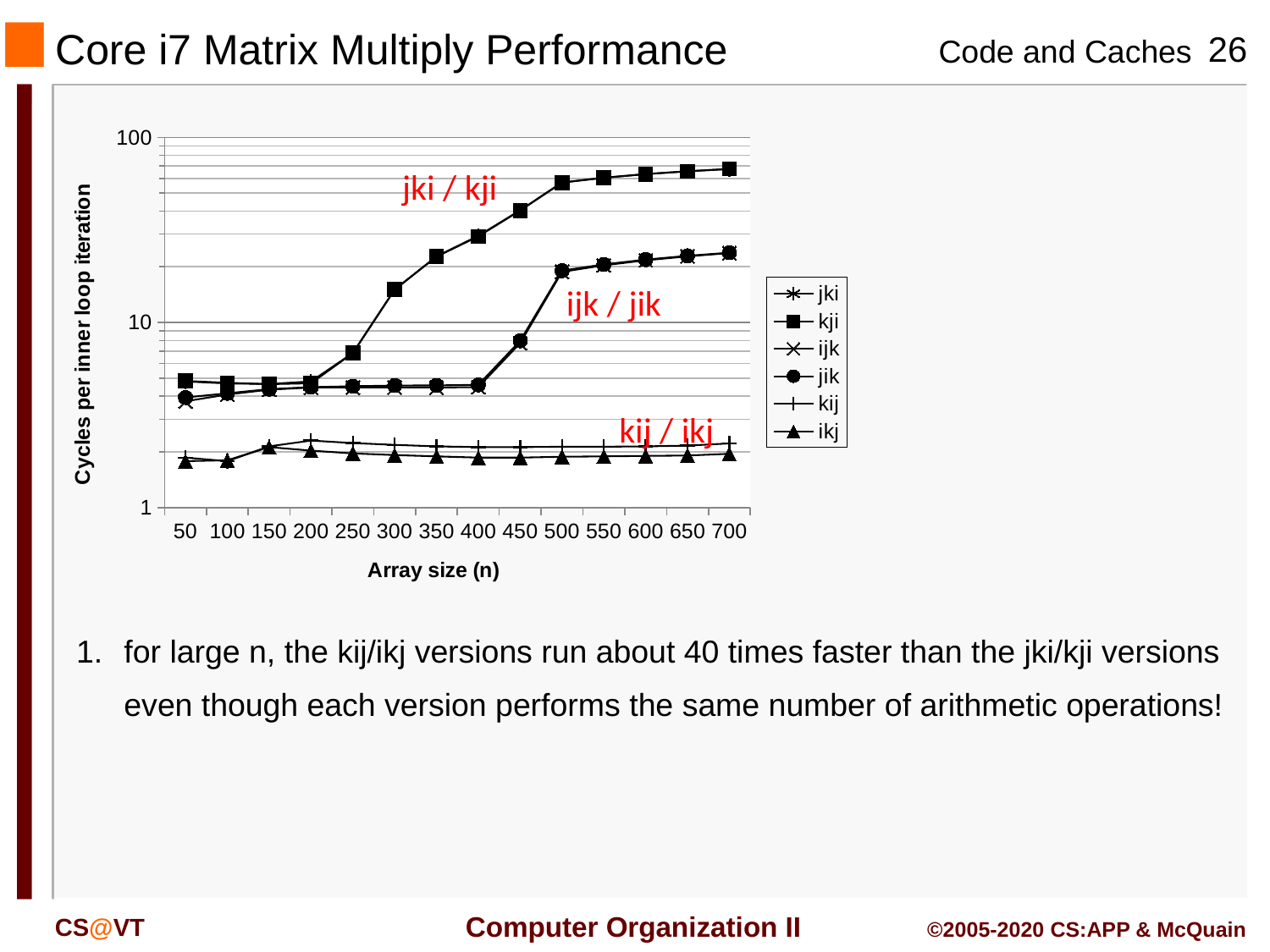
What is the title of the chart's y axis? Cycles per inner loop iteration Is the value for kji at n = 700 greater or less than 100? less Is the value for kji at n = 700 greater or less than 10? greater How many series does the chart's legend list? 6 What kind of chart is shown on the slide? line chart Is the value for ikj at n = 700 greater or less than 10? less Which pair of versions, as labelled on the chart, has the highest cycles per inner loop iteration at n = 700? jki / kji At n = 700, which is larger, the value for kji or the value for ikj? kji What is the title of the chart's x axis? Array size (n) Do the values for kji rise or fall as the array size increases from 50 to 700? rise How many array sizes (n) are plotted along the x axis? 14